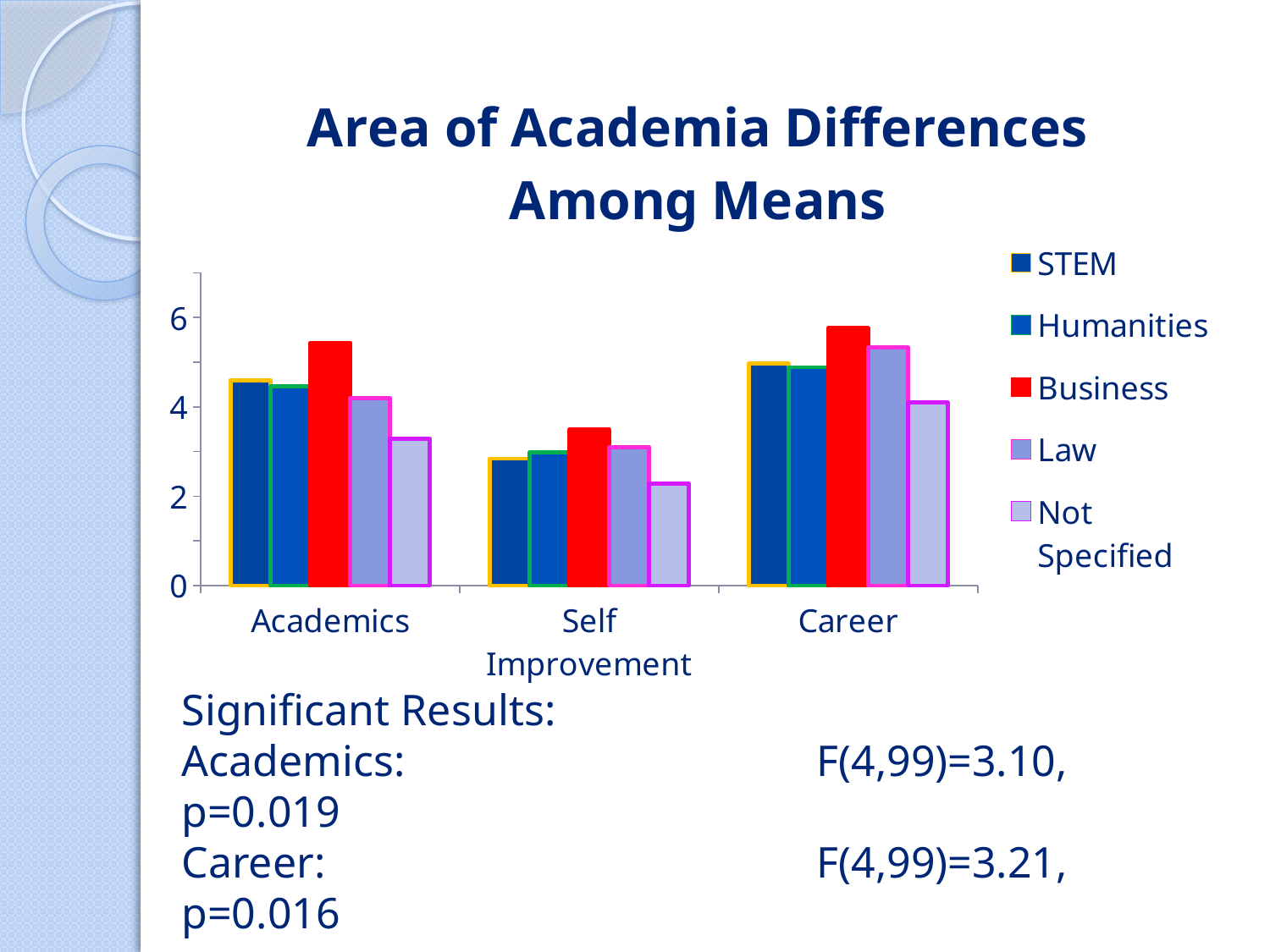
Which series has the highest value in the Academics category? Business In the Career category, which is larger: the Business value or the Not Specified value? Business What kind of chart is shown on the slide? bar chart Which series has the lowest value in the Career category? Not Specified What is the title of the chart on the slide? Area of Academia Differences Among Means Is the Business value for Career greater or less than 6? less How many series does the chart's legend list? 5 Is the Business value for Academics greater or less than 4? greater How many categories are shown on the x axis of the chart? 3 Which series has the highest value in the Career category? Business Is the Not Specified value for Self Improvement greater or less than 4? less Which series has the lowest value in the Self Improvement category? Not Specified